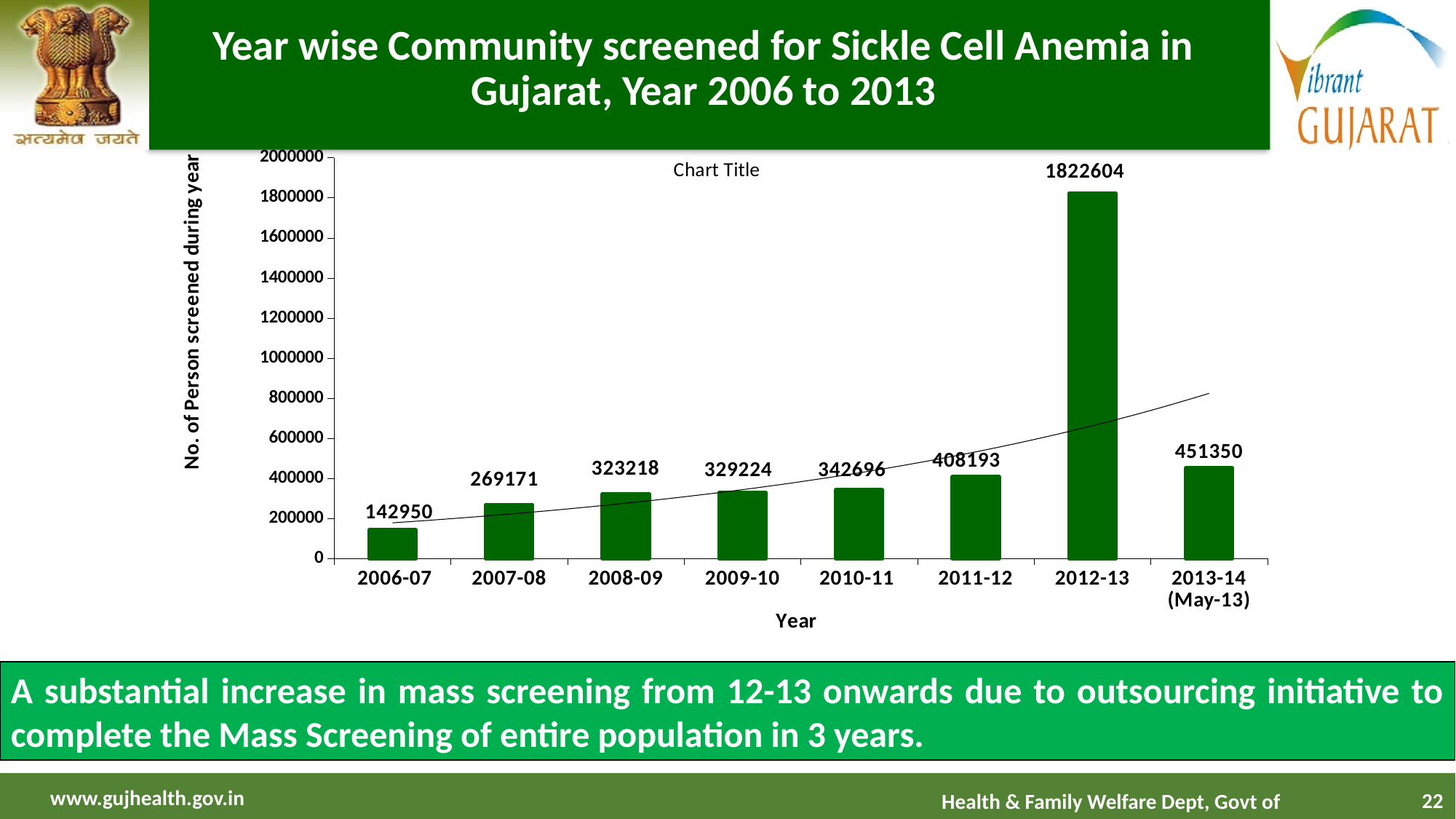
How many persons were screened in 2006-07? 142950 What is the difference between the values for 2007-08 and 2006-07? 126221 Which year has the lowest number of persons screened? 2006-07 What is the value for 2013-14 (May-13)? 451350 How many years (categories) are plotted on the chart? 8 What is the difference between the values for 2012-13 and 2011-12? 1414411 Which year has the highest number of persons screened? 2012-13 What is the value for 2010-11? 342696 What is the value for 2012-13? 1822604 What kind of chart is shown on the slide? Bar chart What is the label on the vertical axis of the chart? No. of Person screened during year Which is larger, the value for 2011-12 or the value for 2013-14 (May-13)? 2013-14 (May-13)